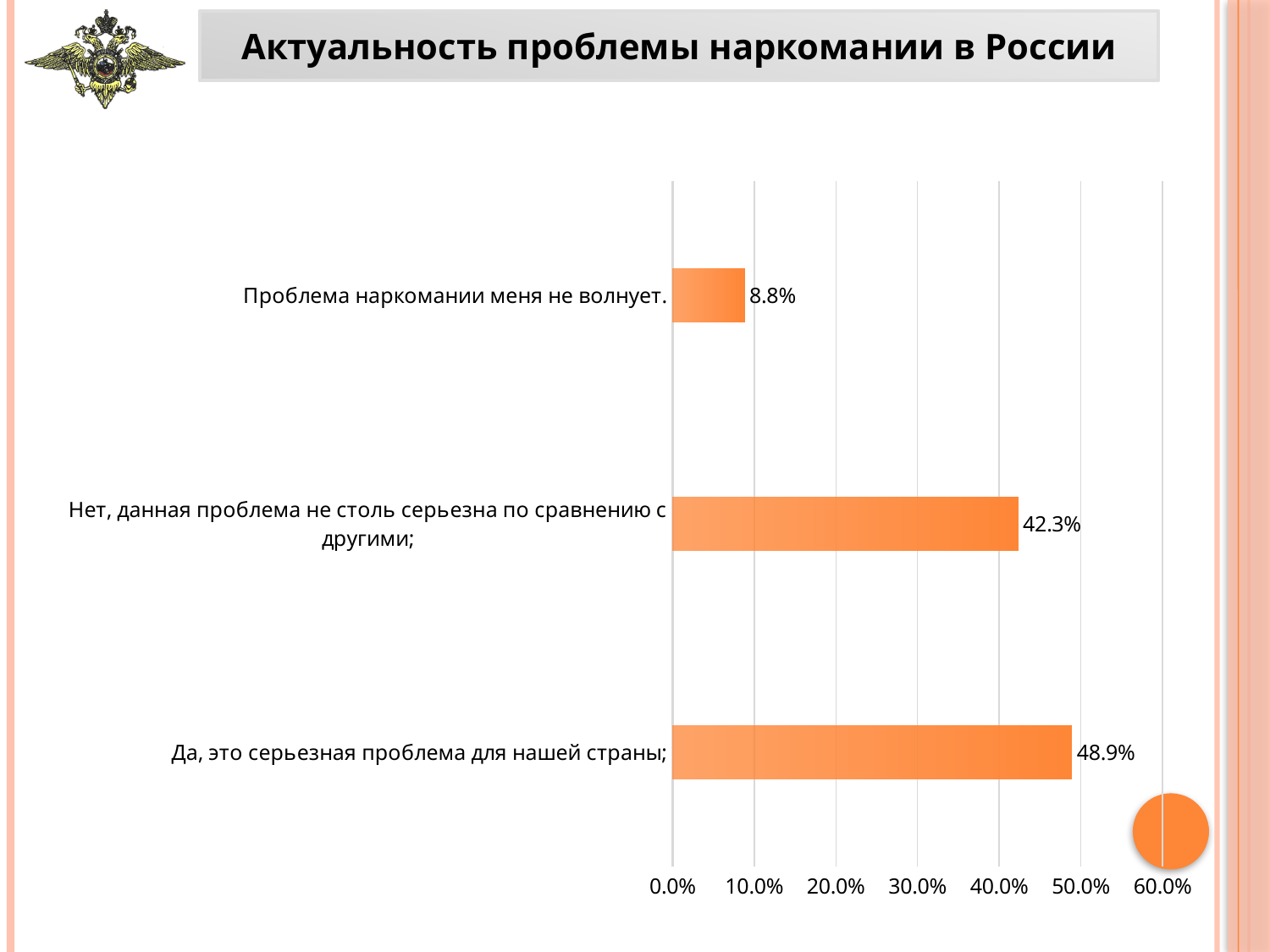
Which category has the lowest value? Проблема наркомании меня не волнует. What kind of chart is shown on the slide? bar chart Which is larger: the value for "Нет, данная проблема не столь серьезна по сравнению с другими;" or for "Проблема наркомании меня не волнует."? Нет, данная проблема не столь серьезна по сравнению с другими; What is the value for "Проблема наркомании меня не волнует."? 8.8% Is the value for "Да, это серьезная проблема для нашей страны;" greater or less than 40.0%? greater What is the value for "Да, это серьезная проблема для нашей страны;"? 48.9% What is the difference between the values for "Да, это серьезная проблема для нашей страны;" and "Нет, данная проблема не столь серьезна по сравнению с другими;"? 6.6% What is the value for "Нет, данная проблема не столь серьезна по сравнению с другими;"? 42.3% How many categories are shown in the chart? 3 What is the title of the slide containing the chart? Актуальность проблемы наркомании в России What is the difference between the values for "Нет, данная проблема не столь серьезна по сравнению с другими;" and "Проблема наркомании меня не волнует."? 33.5% Which category has the highest value? Да, это серьезная проблема для нашей страны;